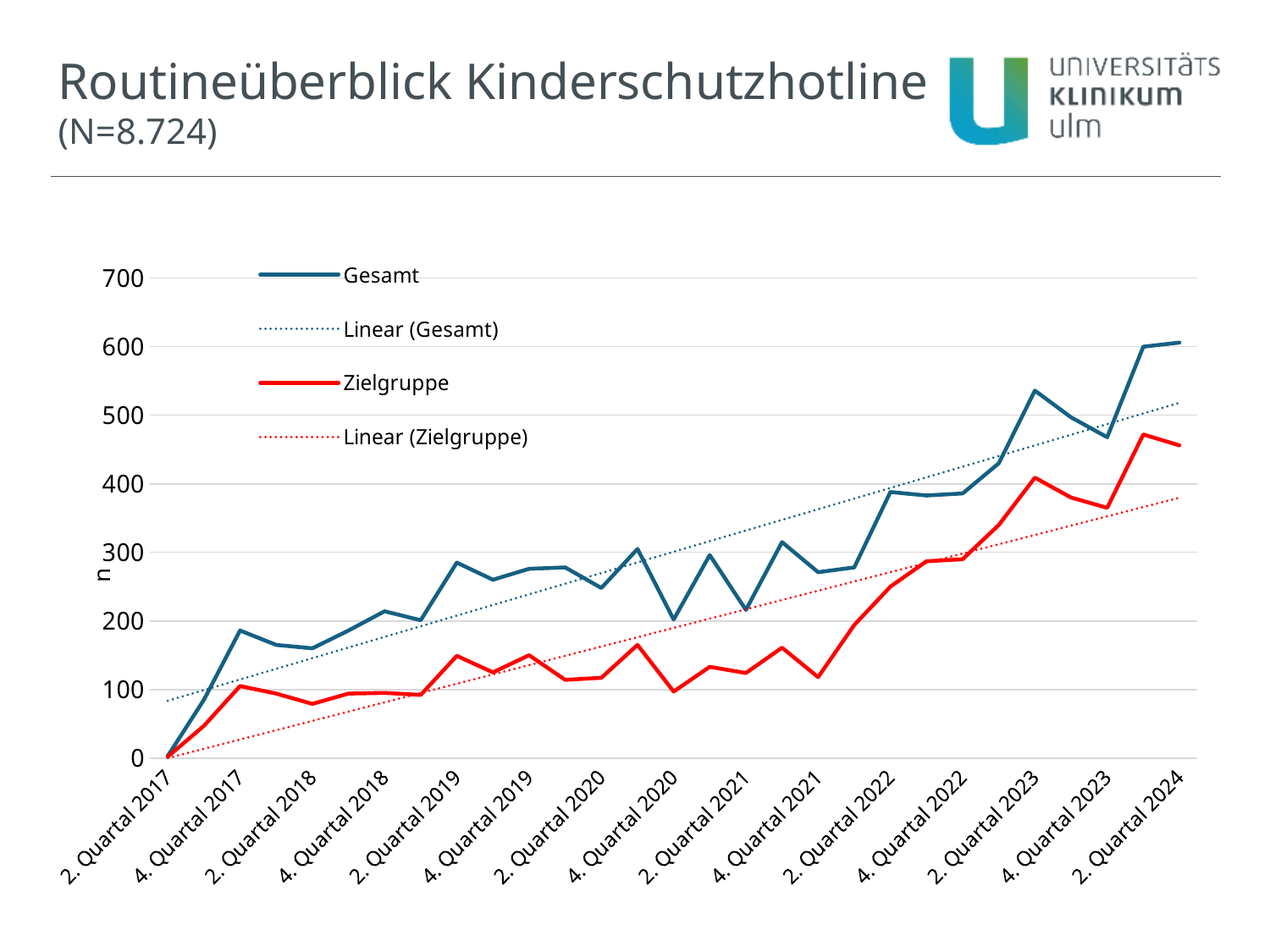
Which colour is used for the Zielgruppe line? red At 2. Quartal 2024, which series has the larger value, Gesamt or Zielgruppe? Gesamt Is the Gesamt value for 2. Quartal 2022 greater or less than 400? less How many entries does the chart legend list? 4 What kind of chart is shown on the slide? line chart What is the label on the y axis of the chart? n Overall, do the Gesamt values rise or fall from 2. Quartal 2017 to 2. Quartal 2024? rise Is the Zielgruppe value for 4. Quartal 2023 greater or less than 400? less Is the Gesamt value for 2. Quartal 2024 greater or less than 500? greater